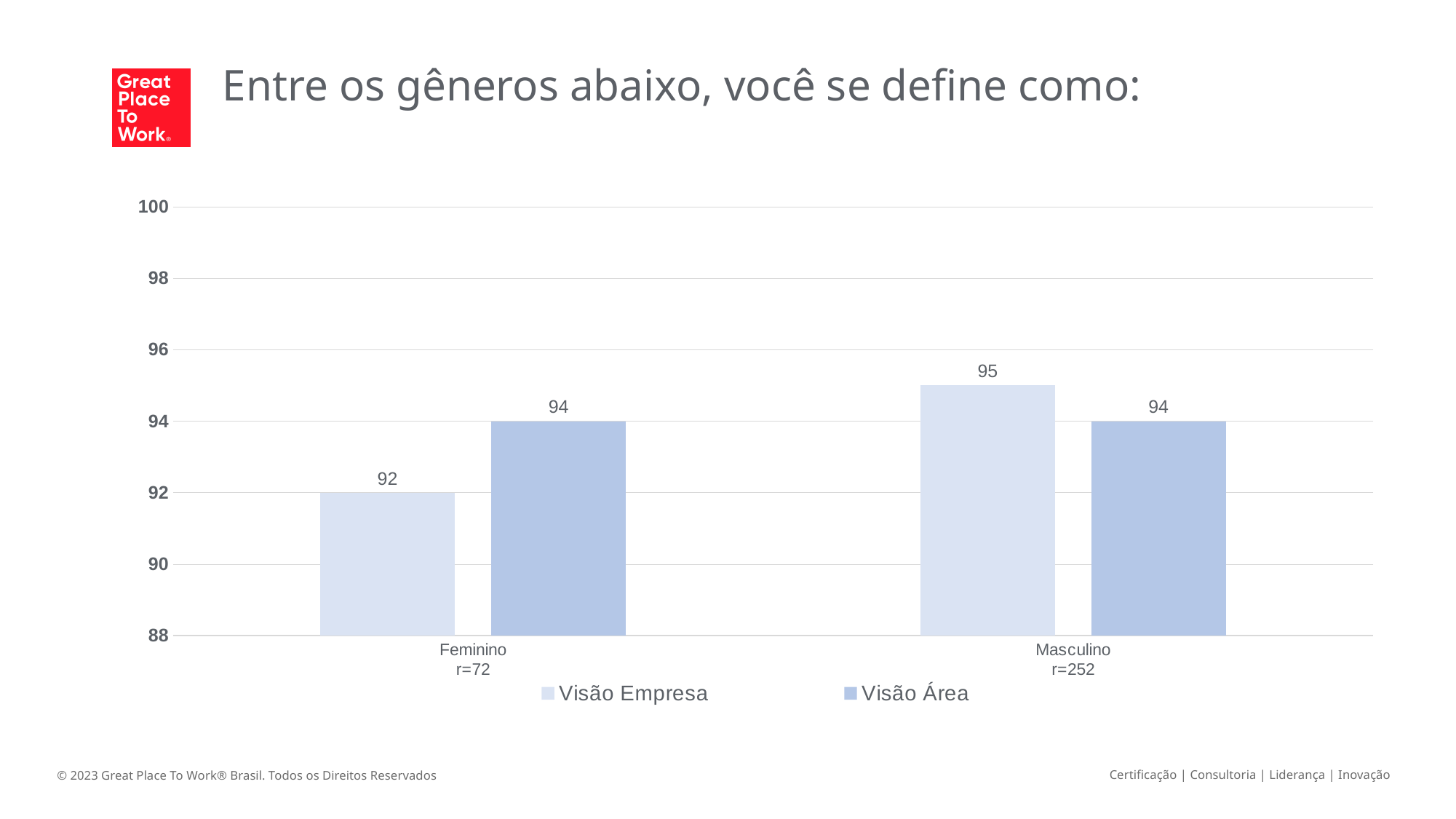
How many categories are shown on the x axis? 2 What is the Visão Área value for Masculino? 94 What is the Visão Empresa value for Masculino? 95 What is the Visão Área value for Feminino? 94 What kind of chart is shown on the slide? Bar chart What is the difference between the Visão Empresa values for Masculino and Feminino? 3 Which category has the highest Visão Empresa value? Masculino How many series does the legend list? 2 Which category has the lowest Visão Empresa value? Feminino For Feminino, which is larger: Visão Empresa or Visão Área? Visão Área What is the title of the chart on the slide? Entre os gêneros abaixo, você se define como: What is the Visão Empresa value for Feminino? 92